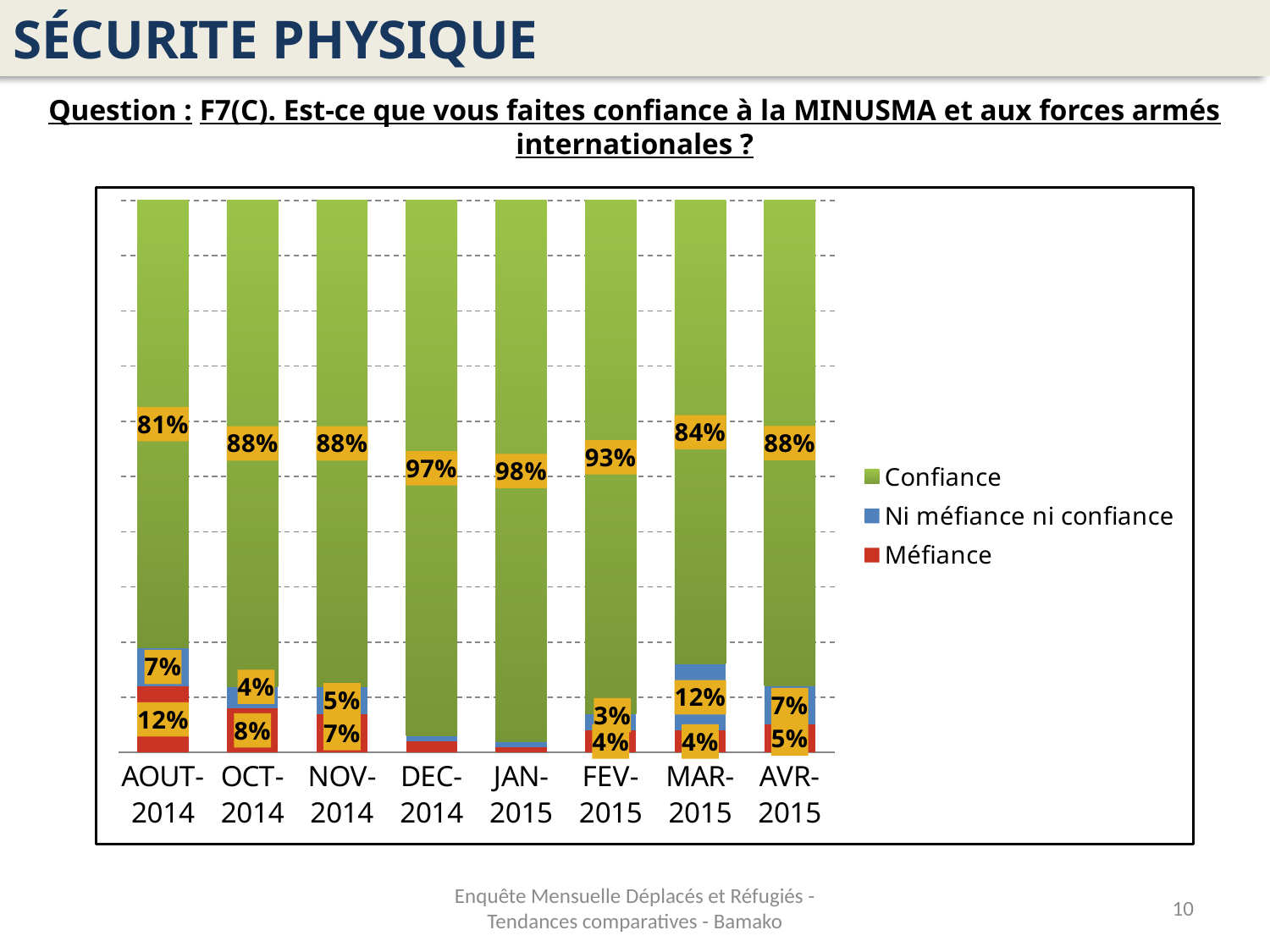
What kind of chart is shown on the slide? Stacked bar chart What is the Confiance value for AOUT-2014? 81% How many months (categories) are shown on the x axis of the chart? 8 How many series does the chart legend list? 3 In which month is the Confiance value highest? JAN-2015 In which month is the Confiance value lowest? AOUT-2014 Which legend entry is shown in green? Confiance What is the difference between the Confiance value for JAN-2015 and for AOUT-2014? 17 percentage points Which is larger, the Méfiance value for AOUT-2014 or for AVR-2015? AOUT-2014 What is the Confiance value for FEV-2015? 93% What is the Méfiance value for OCT-2014? 8% What is the 'Ni méfiance ni confiance' value for MAR-2015? 12%